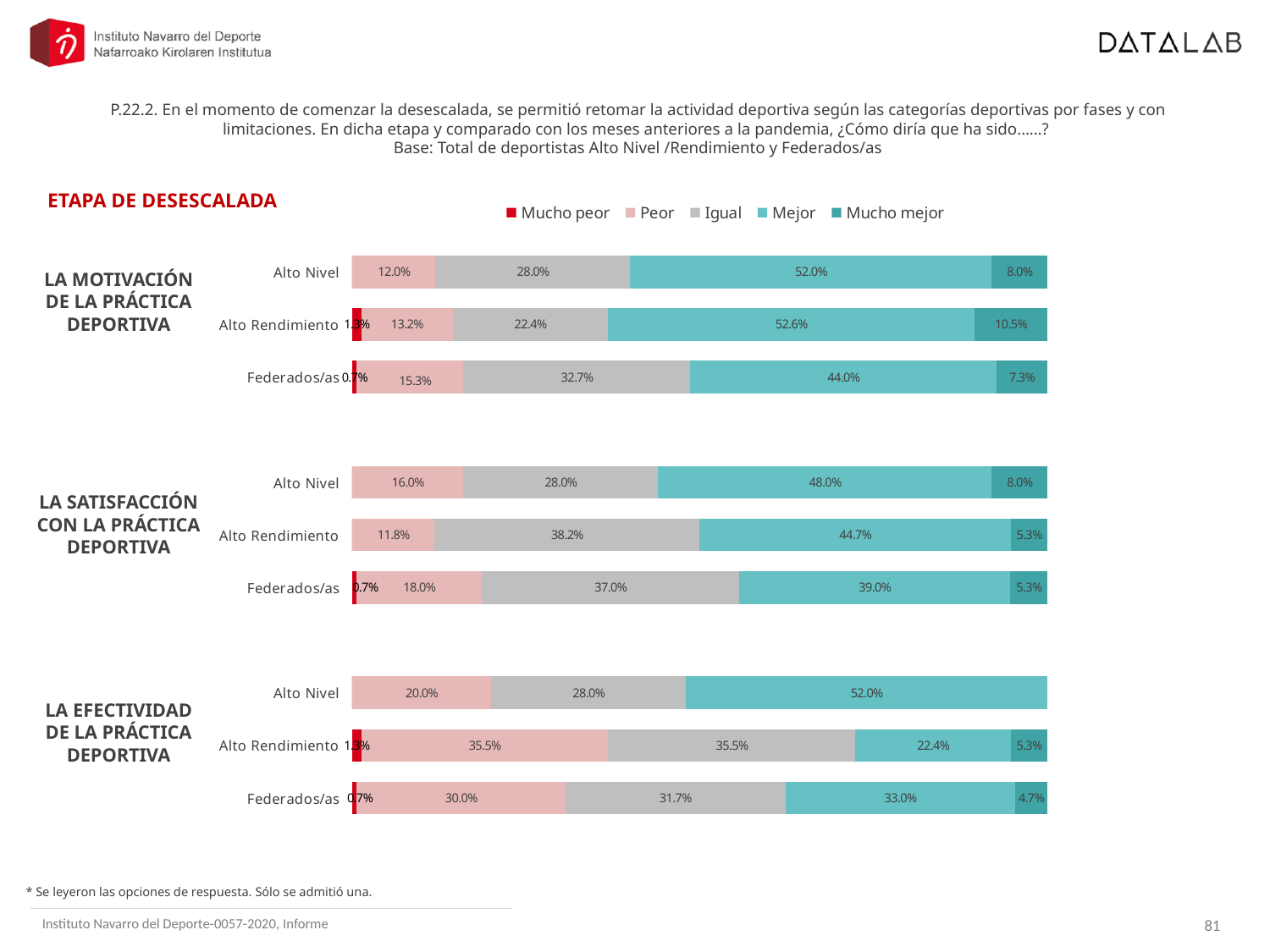
In the 'LA EFECTIVIDAD DE LA PRÁCTICA DEPORTIVA' chart, which category has the highest 'Mejor' value? Alto Nivel In the 'LA MOTIVACIÓN DE LA PRÁCTICA DEPORTIVA' chart, what is the 'Mucho mejor' value for Alto Rendimiento? 10.5% In the 'LA SATISFACCIÓN CON LA PRÁCTICA DEPORTIVA' chart, what is the 'Igual' value for Alto Rendimiento? 38.2% Which legend entry is shown in the darkest teal colour? Mucho mejor How many categories are shown in the 'LA SATISFACCIÓN CON LA PRÁCTICA DEPORTIVA' chart? 3 In the 'LA MOTIVACIÓN DE LA PRÁCTICA DEPORTIVA' chart, what is the 'Mejor' value for Alto Nivel? 52.0% In the 'LA EFECTIVIDAD DE LA PRÁCTICA DEPORTIVA' chart, what is the 'Peor' value for Federados/as? 30.0% In the 'LA EFECTIVIDAD DE LA PRÁCTICA DEPORTIVA' chart, is the 'Peor' value larger for Alto Rendimiento or for Federados/as? Alto Rendimiento In the 'LA MOTIVACIÓN DE LA PRÁCTICA DEPORTIVA' chart, which category has the lowest 'Mejor' value? Federados/as In the 'LA SATISFACCIÓN CON LA PRÁCTICA DEPORTIVA' chart, what is the difference between the 'Mejor' values for Alto Nivel and Federados/as? 9.0% What kind of chart is the 'LA MOTIVACIÓN DE LA PRÁCTICA DEPORTIVA' chart? Stacked bar chart How many series does the legend list for the charts on this slide? 5